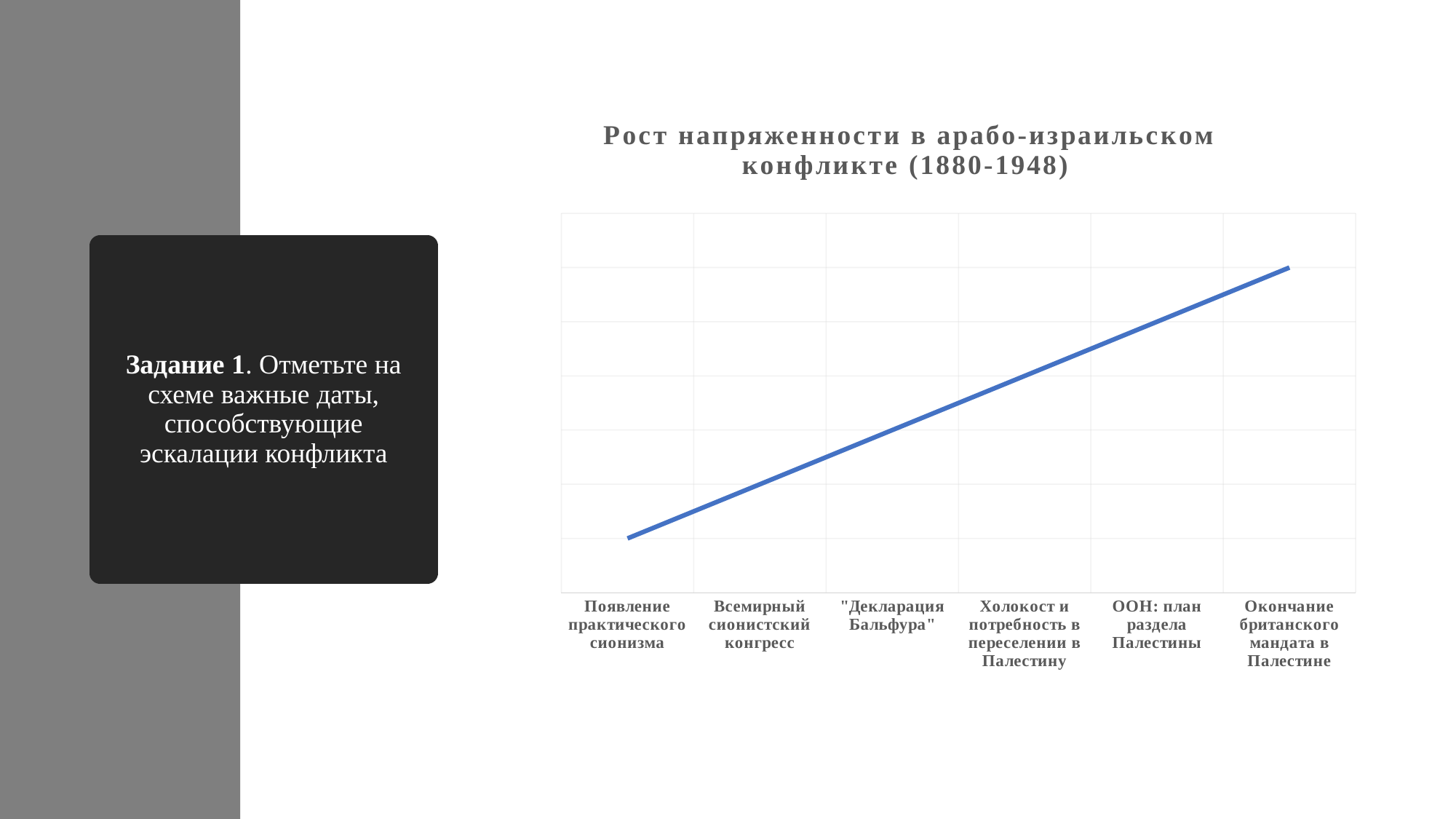
Which has the larger value: "Декларация Бальфура" or Всемирный сионистский конгресс? "Декларация Бальфура" What kind of chart is shown on the slide? line chart Which has the larger value: Холокост и потребность в переселении в Палестину or ООН: план раздела Палестины? ООН: план раздела Палестины Which category has the highest value in the chart? Окончание британского мандата в Палестине What is the title of the chart? Рост напряженности в арабо-израильском конфликте (1880-1948) What colour is the line plotted in the chart? blue Which category has the lowest value in the chart? Появление практического сионизма What is the label of the first category on the x axis of the chart? Появление практического сионизма Do the values in the chart rise or fall from left to right along the x axis? rise How many categories are shown along the x axis of the chart? 6 What is the label of the third category on the x axis of the chart? "Декларация Бальфура"